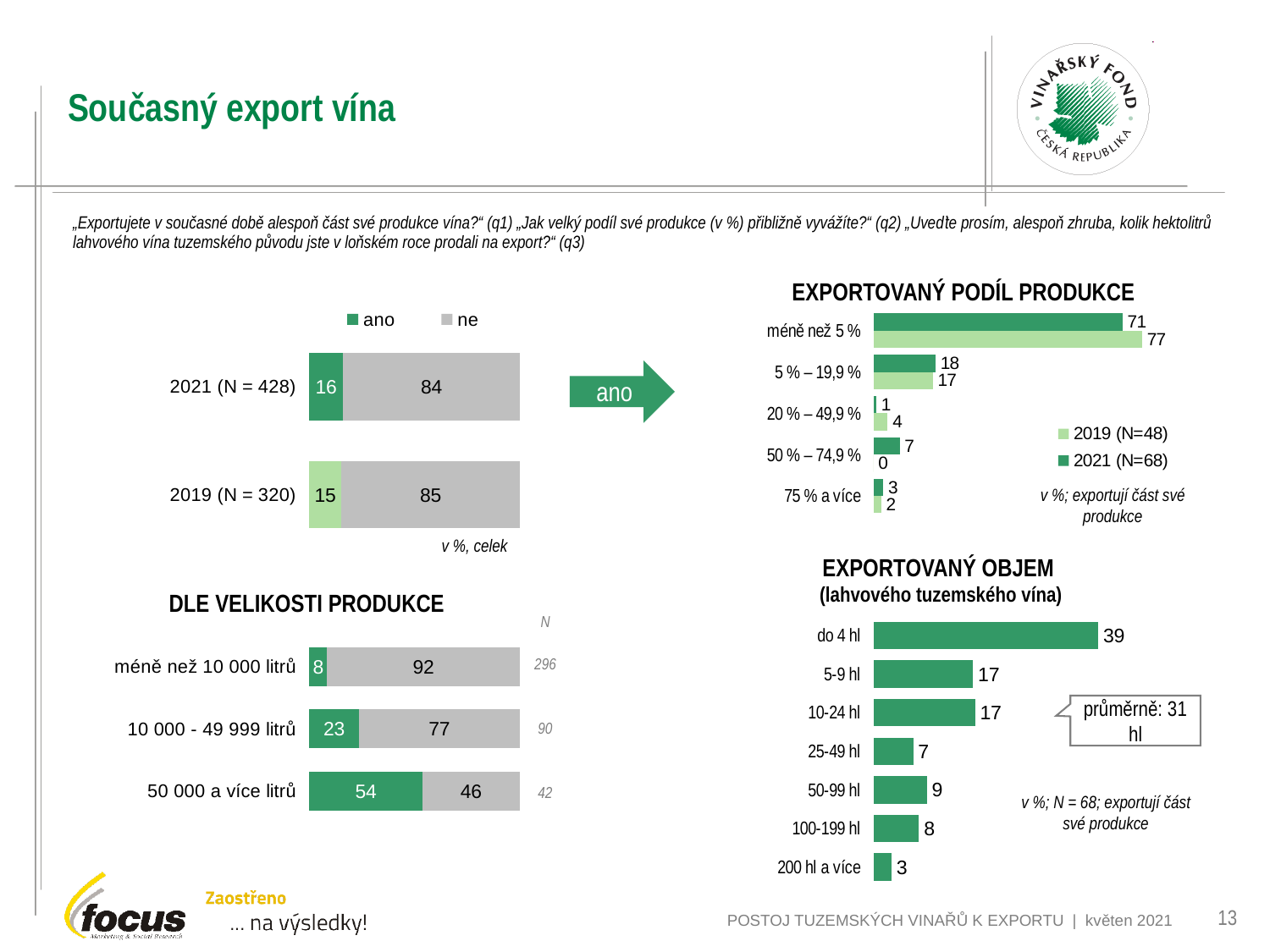
In the top-left chart (ano/ne by year), what is the value for "ano" in 2021 (N = 428)? 16 In the "EXPORTOVANÝ OBJEM" chart, which category has the highest value? do 4 hl In the top-left chart (ano/ne by year), what is the value for "ne" in 2019 (N = 320)? 85 In the "EXPORTOVANÝ PODÍL PRODUKCE" chart, which is larger for "5 % – 19,9 %": the 2019 value or the 2021 value? 2021 In the "DLE VELIKOSTI PRODUKCE" chart, which category has the highest "ano" value? 50 000 a více litrů In the "EXPORTOVANÝ PODÍL PRODUKCE" chart, how many categories are shown? 5 In the "DLE VELIKOSTI PRODUKCE" chart, what is the "ano" value for "50 000 a více litrů"? 54 In the "DLE VELIKOSTI PRODUKCE" chart, what is the difference between the "ne" values for "méně než 10 000 litrů" and "10 000 - 49 999 litrů"? 15 In the "EXPORTOVANÝ OBJEM" chart, what is the value for "50-99 hl"? 9 In the "EXPORTOVANÝ PODÍL PRODUKCE" chart, what is the 2021 (N=68) value for "méně než 5 %"? 71 In the top-left chart (ano/ne by year), how many series does the legend list? 2 What type of chart is the "EXPORTOVANÝ OBJEM" chart? bar chart